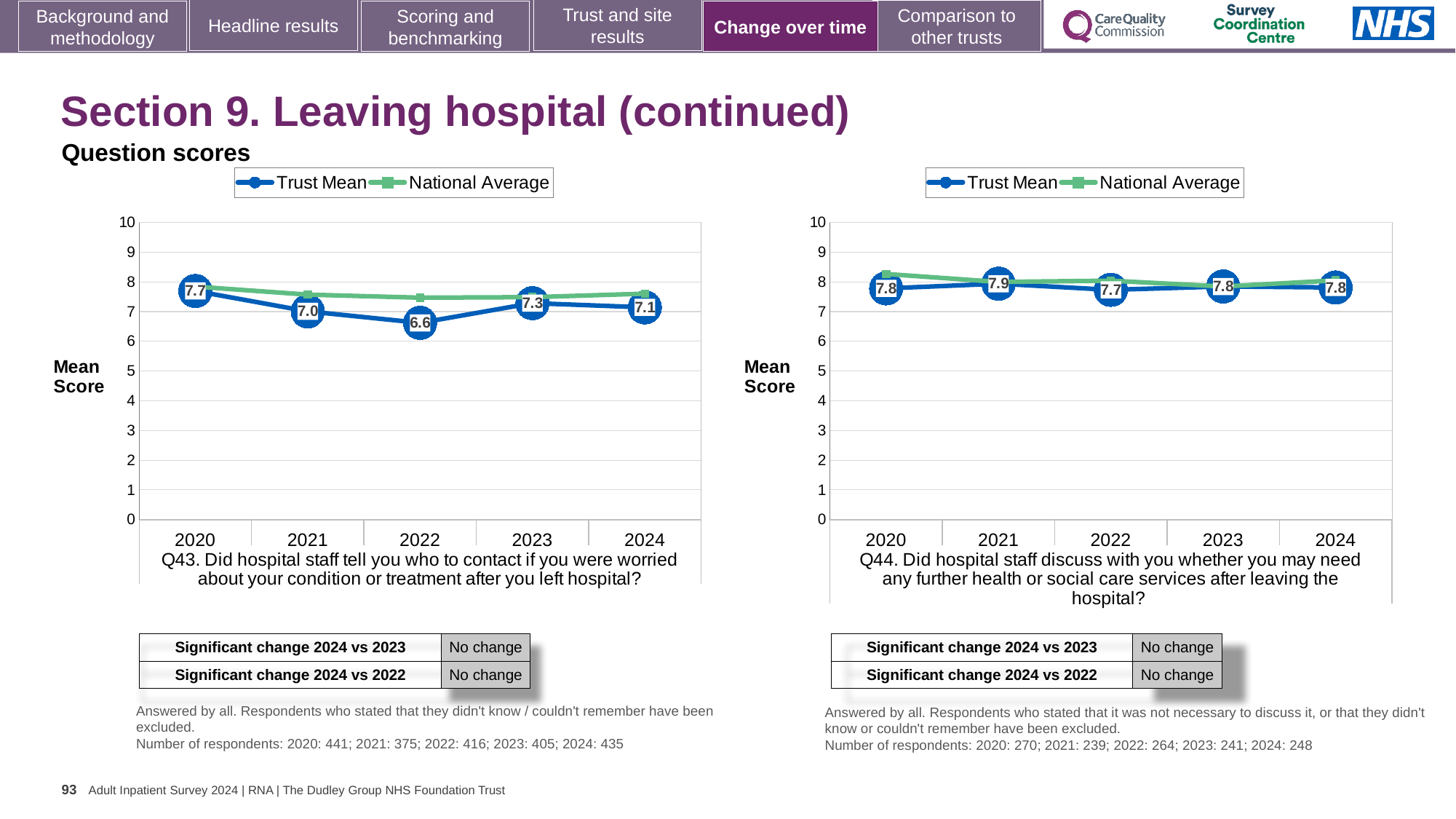
In the Q43 chart on the left, which year has the lowest Trust Mean score? 2022 How many series does the legend of the Q43 chart on the left list? 2 In the Q43 chart on the left, what is the Trust Mean score for 2022? 6.6 In the Q43 chart on the left, which year has the highest Trust Mean score? 2020 In the Q44 chart on the right, is the Trust Mean score for 2021 higher or lower than the score for 2022? higher How many years are plotted on the x axis of the Q44 chart on the right? 5 In the Q44 chart on the right, which year has the lowest Trust Mean score? 2022 In the Q44 chart on the right, what is the Trust Mean score for 2021? 7.9 In the Q43 chart on the left, does the Trust Mean score rise or fall from 2020 to 2022? fall In the Q43 chart on the left, is the National Average value for 2022 greater or less than 7? greater In the Q43 chart on the left, what is the difference between the Trust Mean scores for 2020 and 2022? 1.1 What type of chart is the Q43 chart on the left? line chart